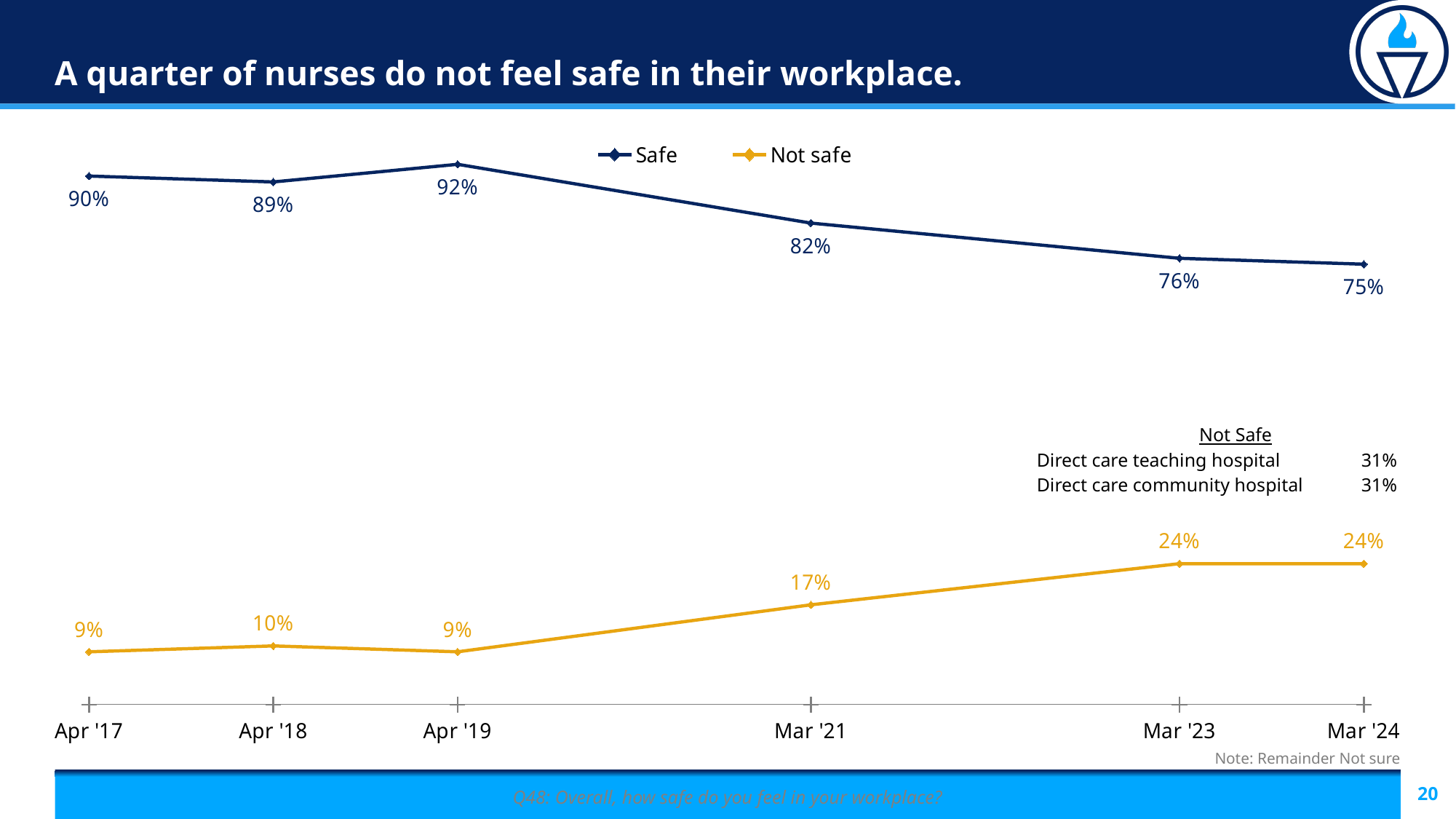
What percentage of nurses felt safe in Apr '19? 92% What kind of chart is shown on the slide? Line chart How many time periods are shown on the x axis? 6 What is the Not safe value for Mar '24? 24% How many series does the legend list? 2 What is the Safe value for Mar '21? 82% In which period was the Safe series at its highest? Apr '19 What is the difference between the Not safe values for Apr '18 and Mar '23? 14 percentage points Which is larger, the Not safe value for Mar '21 or for Apr '18? Mar '21 In which period was the Safe series at its lowest? Mar '24 What is the difference between the Safe values for Apr '17 and Mar '24? 15 percentage points Does the Not safe series rise or fall from Apr '19 to Mar '24? Rise